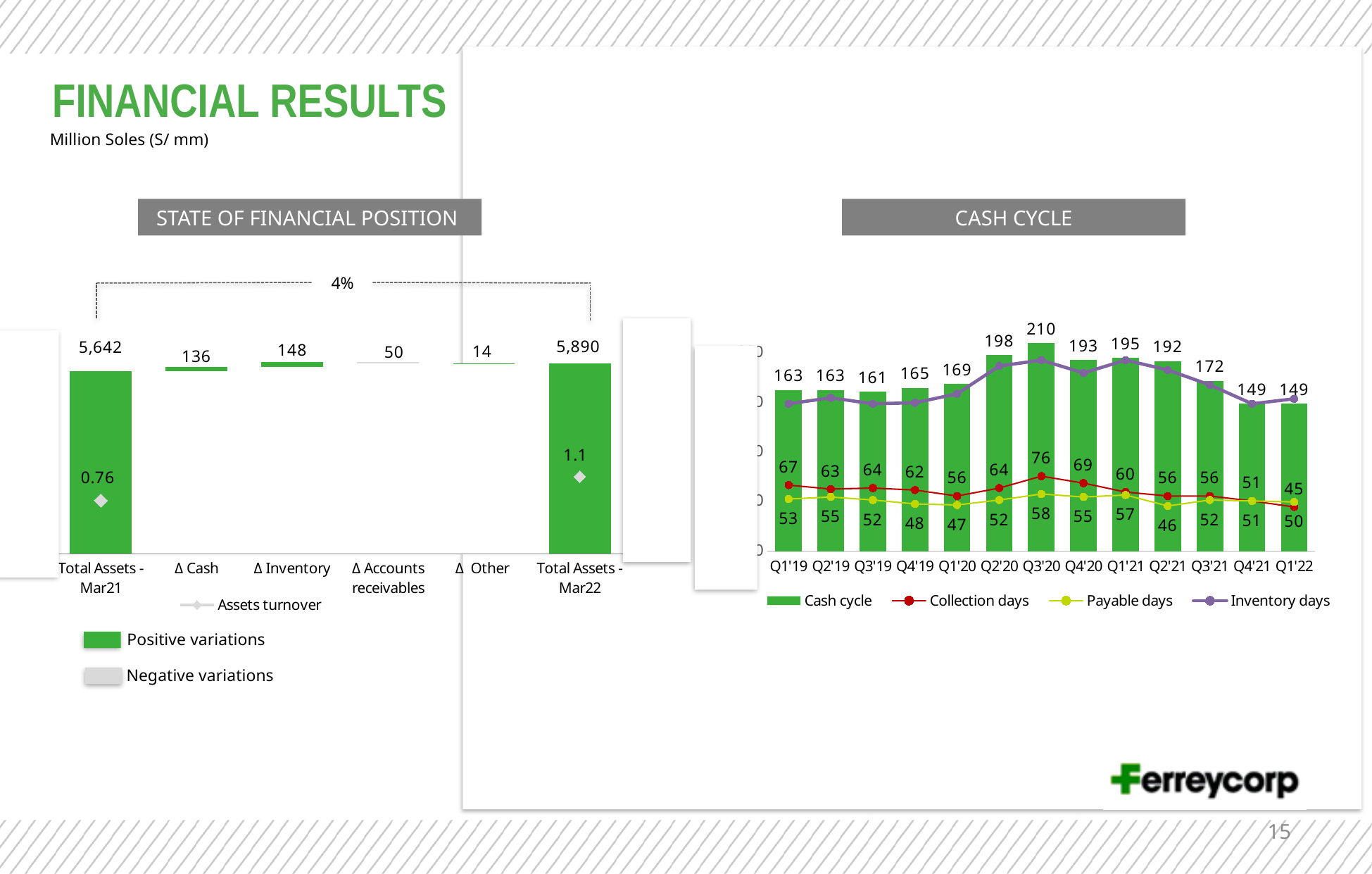
In the STATE OF FINANCIAL POSITION chart, what is the Assets turnover value shown for Total Assets - Mar22? 1.1 In the CASH CYCLE chart, what is the Payable days value for Q2'21? 46 In the CASH CYCLE chart, what is the Cash cycle value for Q3'20? 210 In the CASH CYCLE chart, how many series does the legend list? 4 In the STATE OF FINANCIAL POSITION chart, what is the value for Δ Inventory? 148 In the CASH CYCLE chart, what is the difference between the Cash cycle values for Q3'20 and Q1'22? 61 In the CASH CYCLE chart, which quarter has the highest Cash cycle value? Q3'20 In the STATE OF FINANCIAL POSITION chart, what is the value for Total Assets - Mar22? 5,890 In the CASH CYCLE chart, how many quarters are shown on the x axis? 13 In the CASH CYCLE chart, which is larger for Q3'20: Collection days or Payable days? Collection days In the CASH CYCLE chart, what is the Collection days value for Q1'22? 45 In the STATE OF FINANCIAL POSITION chart, what is the difference between Total Assets - Mar22 and Total Assets - Mar21? 248